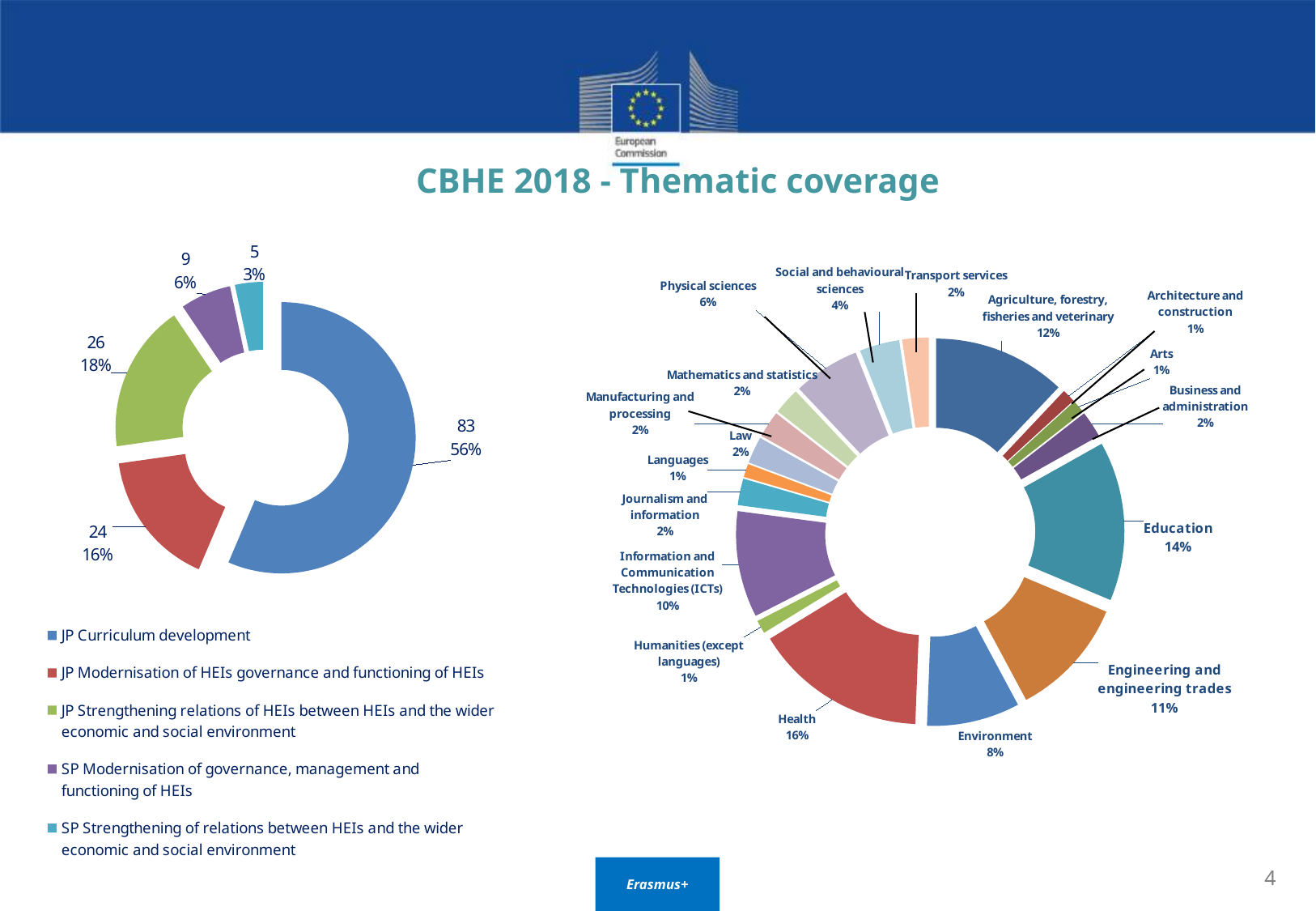
What type of chart is the left chart on the slide? Doughnut chart On the right doughnut chart, what percentage is shown for Health? 16% On the right doughnut chart, which is larger: Engineering and engineering trades or Environment? Engineering and engineering trades On the right doughnut chart, which thematic area has the largest share? Health On the left doughnut chart, how many projects are in the JP Curriculum development category? 83 On the right doughnut chart, what percentage is shown for Education? 14% On the left doughnut chart, what is the difference between the JP Strengthening relations value (26) and the JP Modernisation value (24)? 2 What is the title of the slide containing the two doughnut charts? CBHE 2018 - Thematic coverage On the right doughnut chart, what is the difference in percentage points between Agriculture, forestry, fisheries and veterinary (12%) and Physical sciences (6%)? 6 percentage points On the left doughnut chart, how many categories does the legend list? 5 On the left doughnut chart, what percentage share does JP Modernisation of HEIs governance and functioning of HEIs have? 16% On the left doughnut chart, which category has the smallest value? SP Strengthening of relations between HEIs and the wider economic and social environment